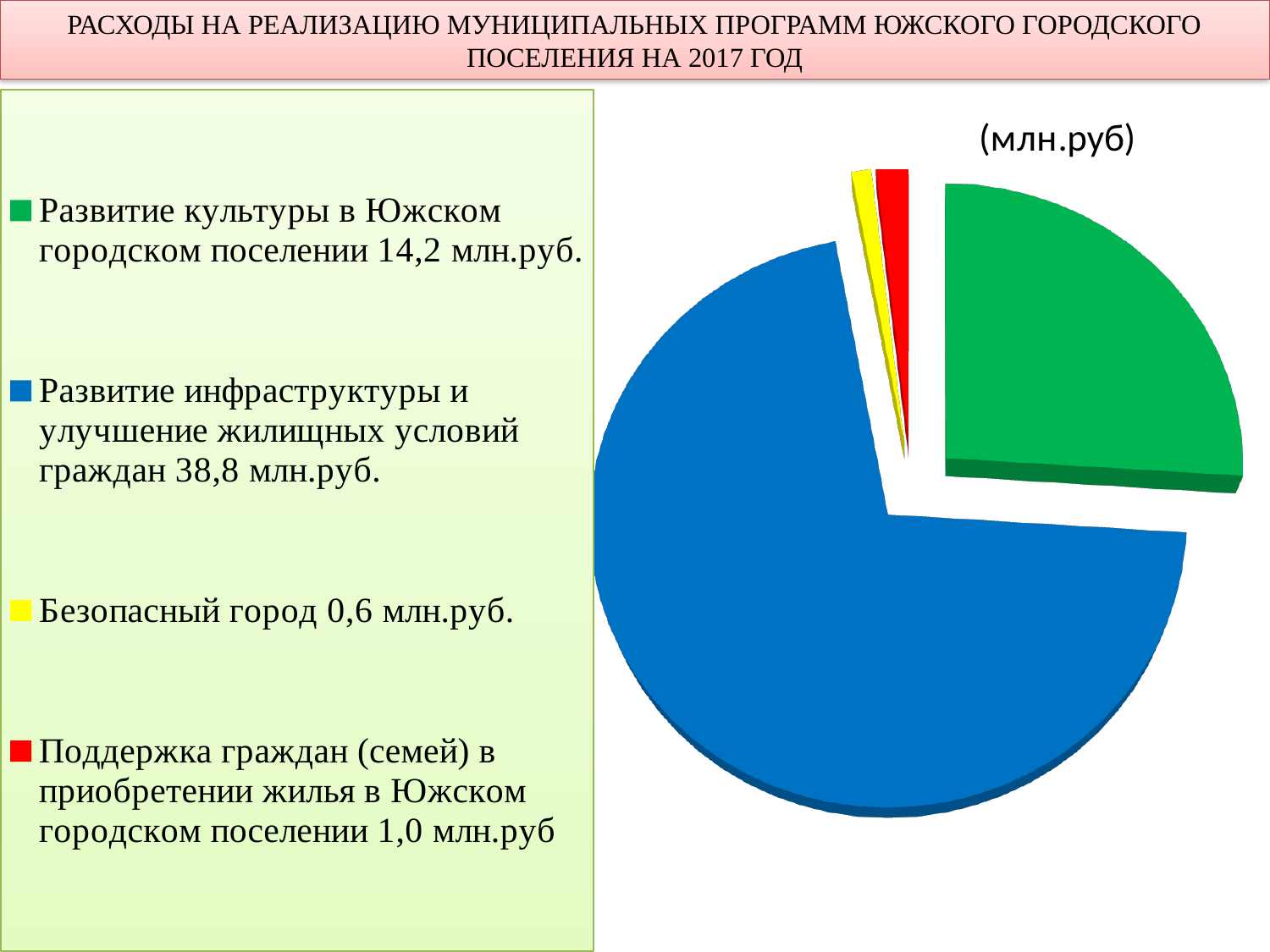
What is the value for «Поддержка граждан (семей) в приобретении жилья в Южском городском поселении»? 1,0 млн.руб What is the value for «Развитие инфраструктуры и улучшение жилищных условий граждан»? 38,8 млн.руб. Which is larger: the value for «Поддержка граждан (семей) в приобретении жилья» or for «Безопасный город»? Поддержка граждан (семей) в приобретении жилья What is the difference between the values for «Развитие инфраструктуры и улучшение жилищных условий граждан» and «Развитие культуры в Южском городском поселении»? 24,6 млн.руб. What is the value for «Развитие культуры в Южском городском поселении»? 14,2 млн.руб. What is the value for «Безопасный город»? 0,6 млн.руб. Which category has the smallest share of the pie? Безопасный город What colour is the slice for «Развитие культуры в Южском городском поселении»? Green How many categories does the pie chart's legend list? 4 What is the total of all four categories shown in the pie chart? 54,6 млн.руб. What kind of chart is shown on the slide? Pie chart Which category has the largest share of the pie? Развитие инфраструктуры и улучшение жилищных условий граждан